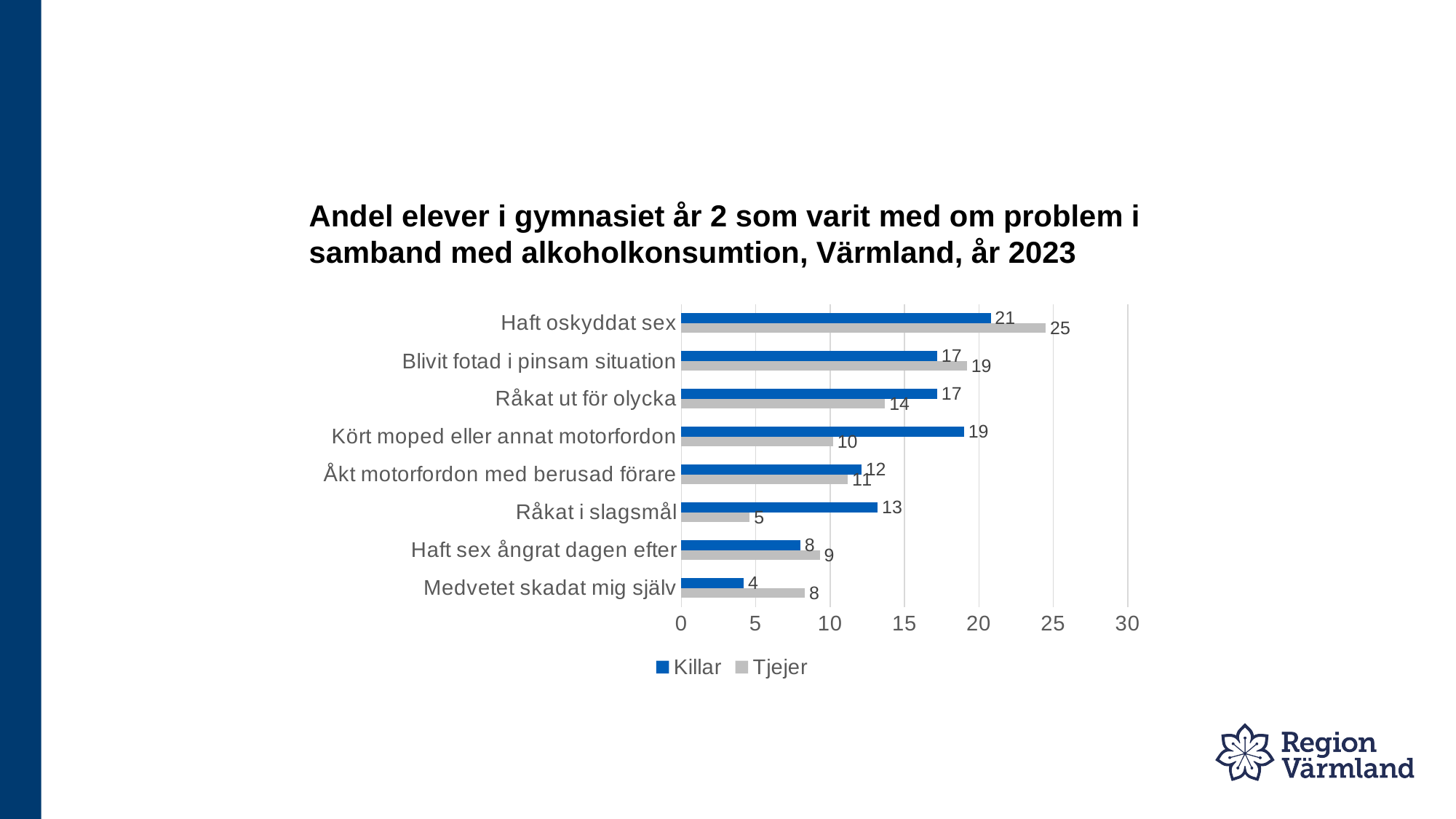
What is the value for Tjejer for "Råkat i slagsmål"? 5 Which category has the highest value for Tjejer? Haft oskyddat sex What is the difference between the Tjejer and Killar values for "Haft oskyddat sex"? 4 How many categories are shown on the chart? 8 What is the value for Tjejer for "Kört moped eller annat motorfordon"? 10 Which series is shown in blue? Killar Is the value for Killar for "Kört moped eller annat motorfordon" greater or less than 15? greater Which is larger for "Råkat ut för olycka": the Killar value or the Tjejer value? Killar What kind of chart is shown on the slide? Bar chart How many series does the legend list? 2 Which category has the lowest value for Killar? Medvetet skadat mig själv What is the value for Killar for "Haft oskyddat sex"? 21